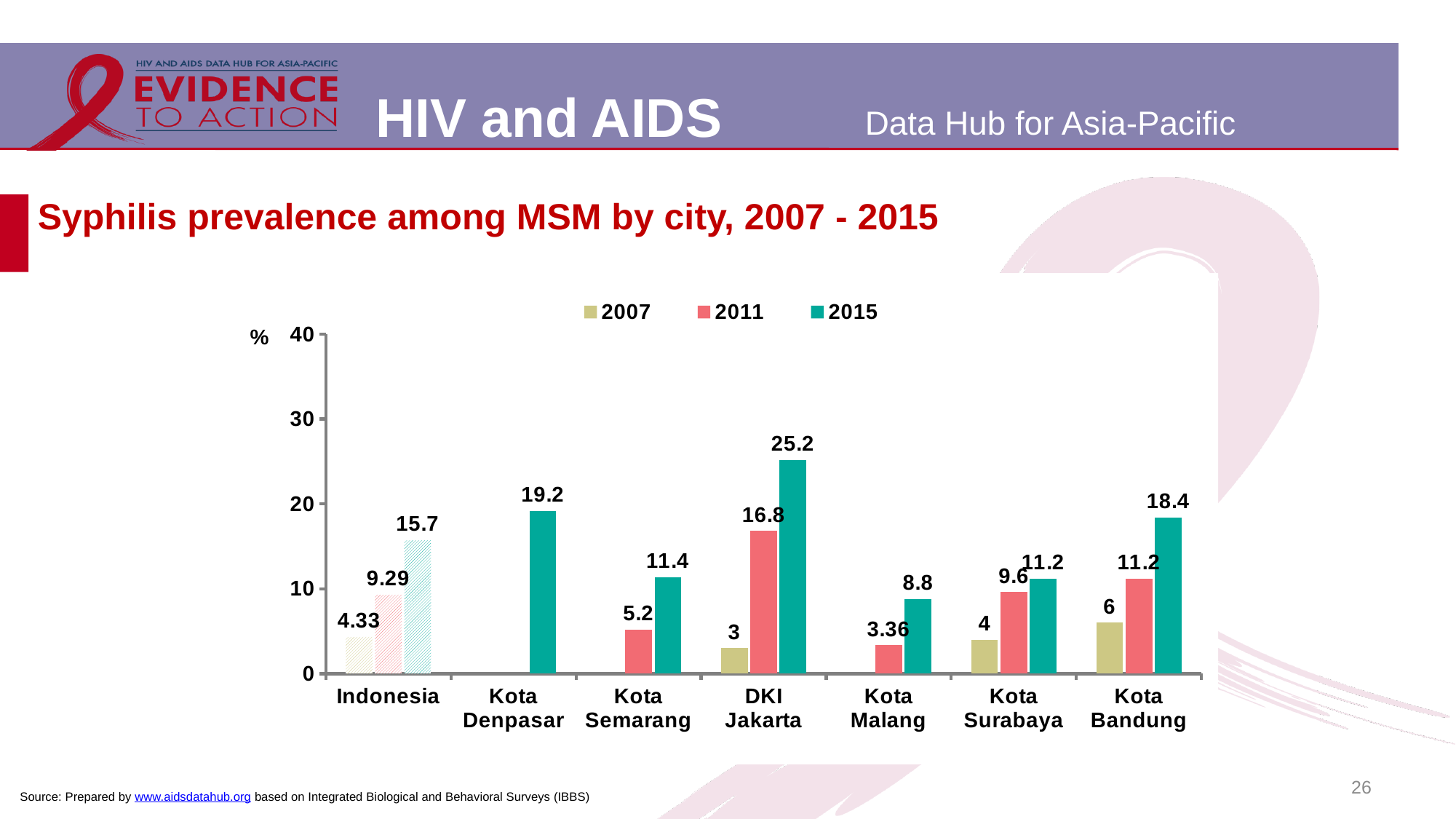
What is the 2015 syphilis prevalence value for DKI Jakarta? 25.2 What is the difference between the 2015 and 2011 values for Kota Bandung? 7.2 Do the values for Indonesia rise or fall from 2007 to 2015? Rise How many series does the legend list? 3 What kind of chart is shown on the slide? Bar chart Which city has the highest 2015 value? DKI Jakarta Which category has the lowest 2015 value? Kota Malang What is the 2015 value for Kota Denpasar? 19.2 Which is larger: the 2011 value for DKI Jakarta or the 2011 value for Kota Bandung? DKI Jakarta What is the 2007 value for Indonesia? 4.33 How many cities or categories are shown on the x axis? 7 What is the 2011 value for Kota Malang? 3.36